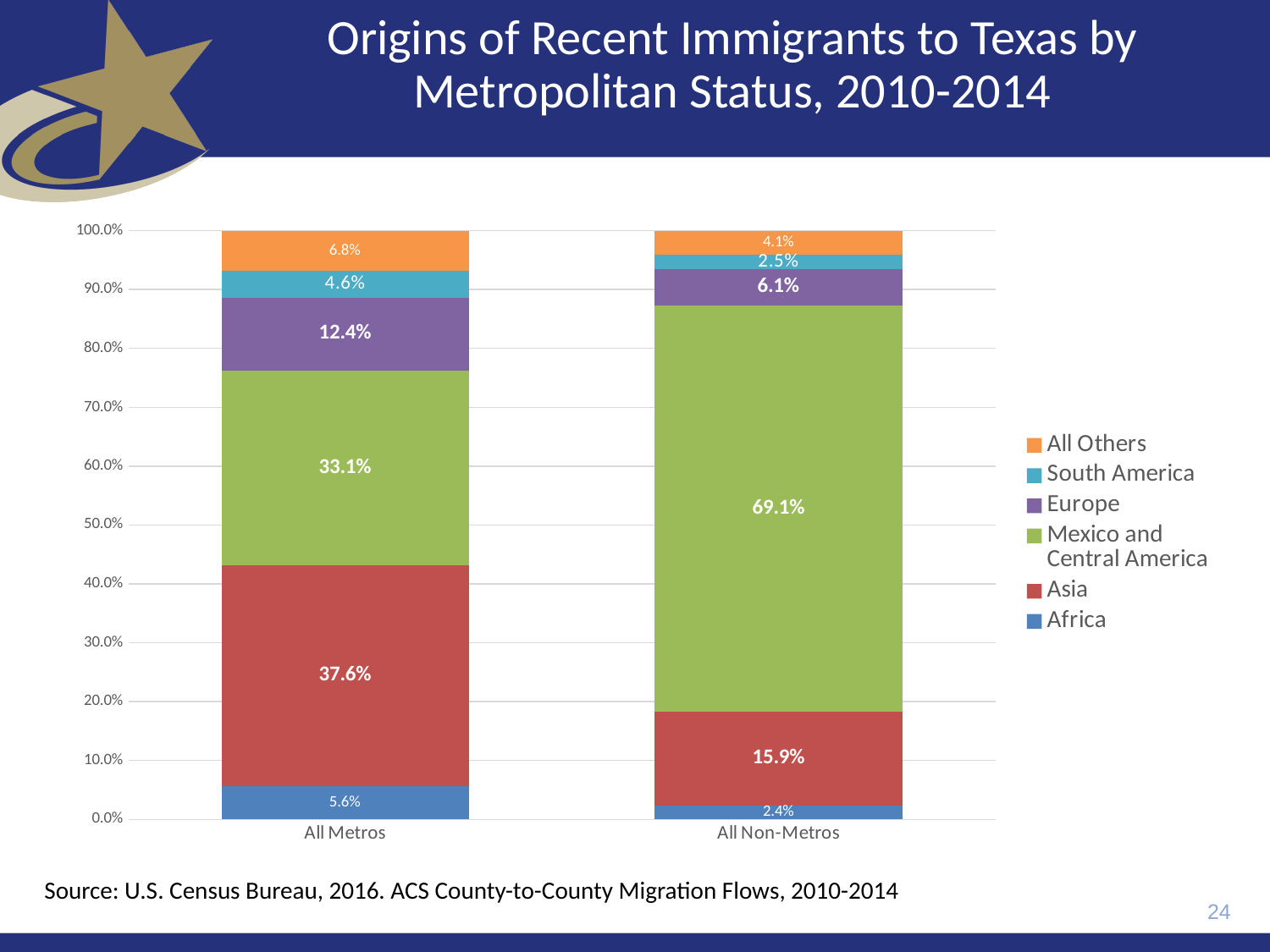
How many series does the legend list? 6 What kind of chart is shown on the slide? Stacked bar chart Which has a larger Asia share, All Metros or All Non-Metros? All Metros How much larger is the Mexico and Central America share for All Non-Metros than for All Metros? 36.0 percentage points What is the South America share for All Metros? 4.6% What share of recent immigrants to All Metros came from Asia? 37.6% What is the Africa share for All Non-Metros? 2.4% Which origin region has the largest share for All Non-Metros? Mexico and Central America How many categories are shown on the x axis? 2 What is the Europe share for All Metros? 12.4% Which origin region has the smallest share for All Metros? South America What share of recent immigrants to All Non-Metros came from Mexico and Central America? 69.1%